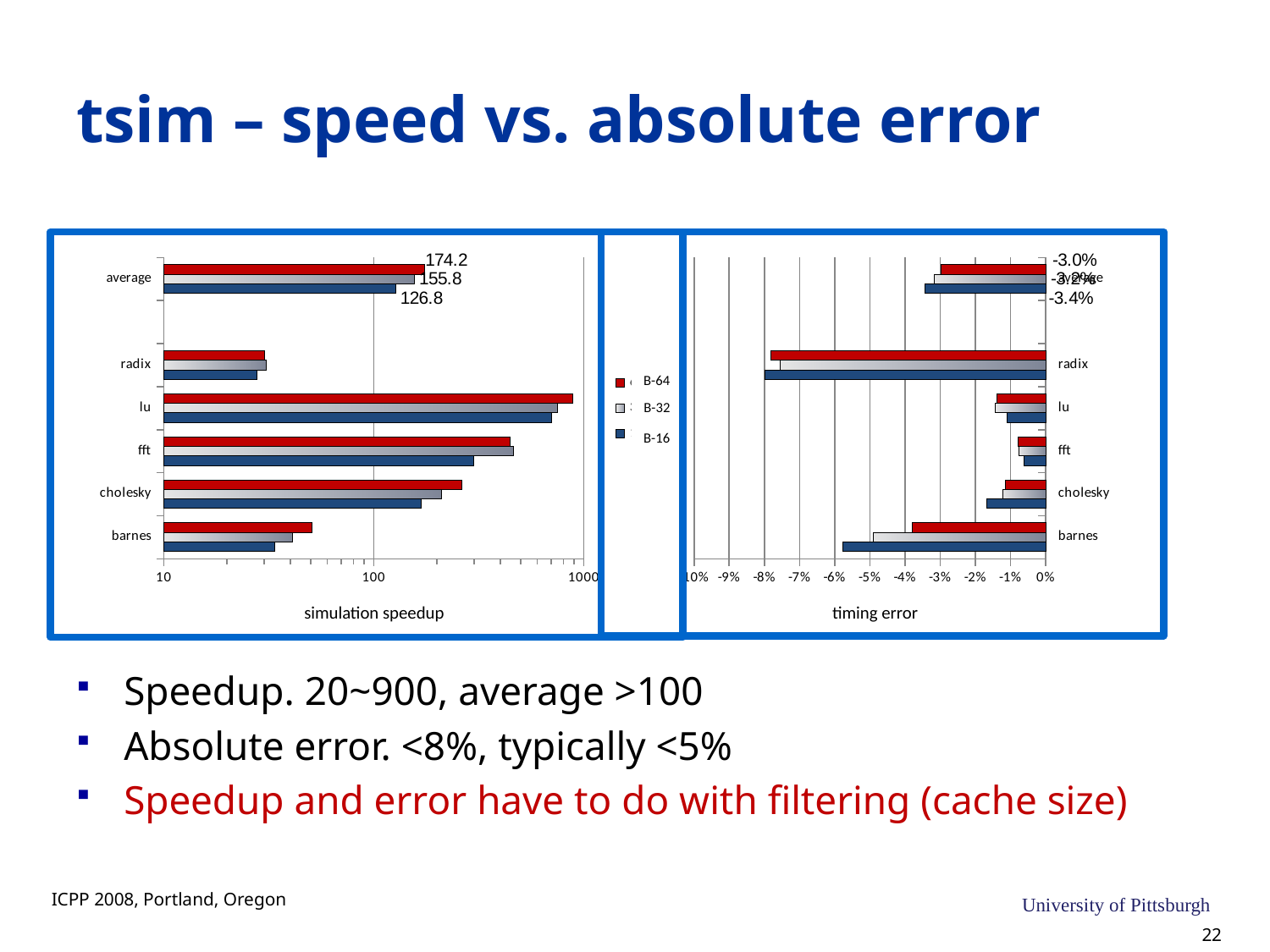
What kind of chart is the simulation speedup chart? bar chart In the timing error chart, what is the average timing error for B-16? -3.4% In the simulation speedup chart, which category has the lowest B-64 speedup? radix How many series does the legend list? 3 In the simulation speedup chart, which category has the highest B-64 speedup? lu In the simulation speedup chart, is the B-64 speedup for lu greater or less than 100? greater In the simulation speedup chart, what is the average speedup for B-64? 174.2 In the simulation speedup chart, what is the average speedup for B-16? 126.8 In the simulation speedup chart, what is the difference between the average speedup for B-64 and for B-16? 47.4 In the timing error chart, which category has the largest timing error in magnitude? radix In the timing error chart, what is the average timing error for B-64? -3.0% In the simulation speedup chart, what is the average speedup for B-32? 155.8